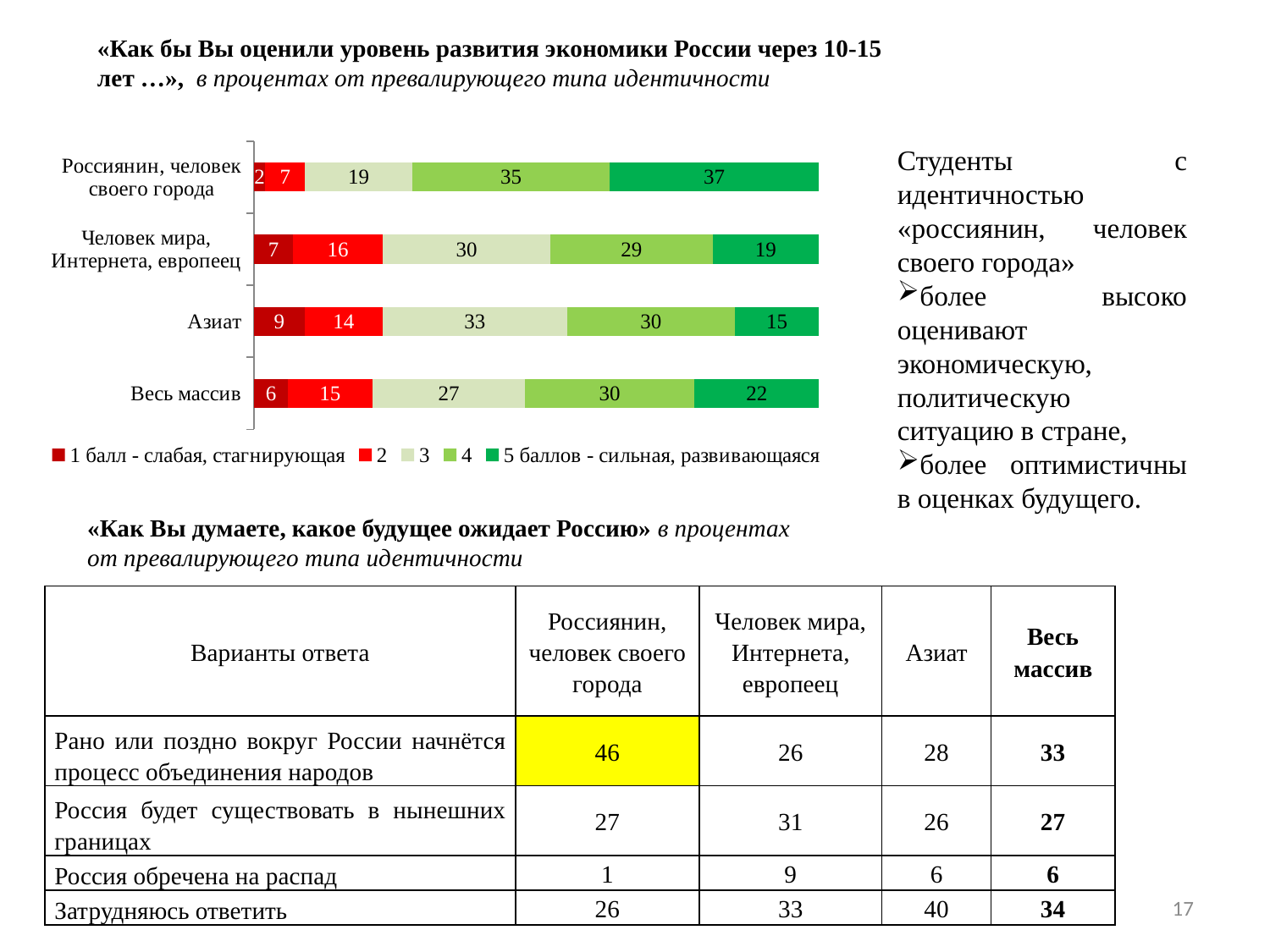
How many categories are shown on the chart? 4 How many series does the chart legend list? 5 What is the value of series '3' for the 'Азиат' category? 33 What is the total of the stacked bar for 'Весь массив'? 100 Which category has the lowest value for the '1 балл - слабая, стагнирующая' series? Россиянин, человек своего города Which category has the highest value for the '5 баллов - сильная, развивающаяся' series? Россиянин, человек своего города What is the value of the '5 баллов - сильная, развивающаяся' series for 'Россиянин, человек своего города'? 37 What type of chart is shown on the slide? Stacked bar chart What is the value of series '2' for 'Человек мира, Интернета, европеец'? 16 Which category has the larger value for series '4': 'Россиянин, человек своего города' or 'Человек мира, Интернета, европеец'? Россиянин, человек своего города What is the legend label of the first (dark red) series? 1 балл - слабая, стагнирующая What is the difference between the '5 баллов - сильная, развивающаяся' values for 'Россиянин, человек своего города' and 'Азиат'? 22